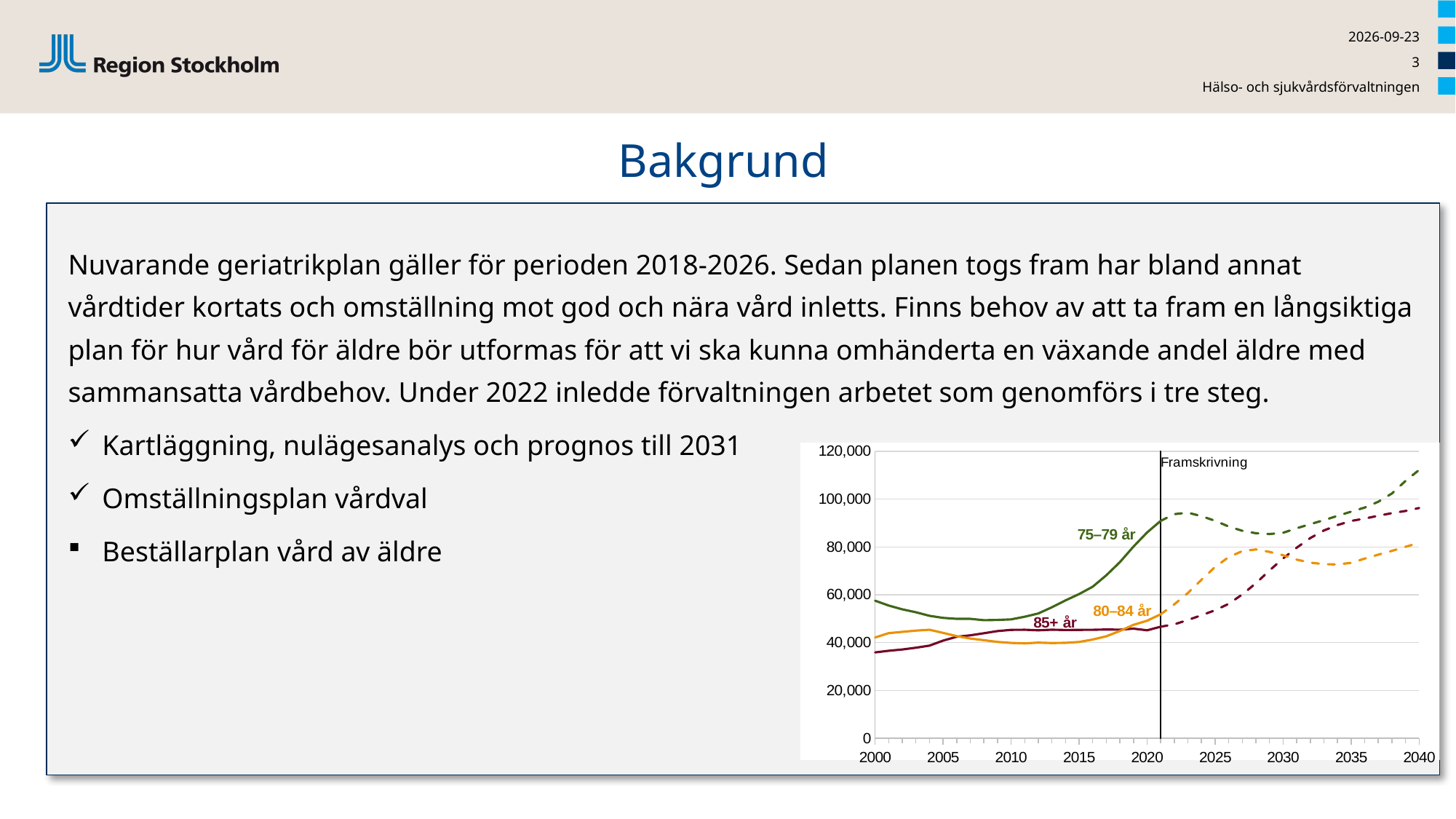
Is the value for 80–84 år in 2040 greater or less than 100,000? less How many age-group series are plotted in the chart? 3 What label is written next to the vertical line in the chart? Framskrivning Which age group has the lowest value in 2000? 85+ år Is the value for 75–79 år in 2020 greater or less than 80,000? greater Is the value for 85+ år in 2000 greater or less than 40,000? less Does the value for 75–79 år rise or fall between 2010 and 2020? rise What kind of chart is shown on the slide? Line chart In 2040, which is larger: the value for 75–79 år or the value for 80–84 år? 75–79 år Which age group has the highest value in 2040? 75–79 år What is the highest value shown on the chart's vertical axis? 120,000